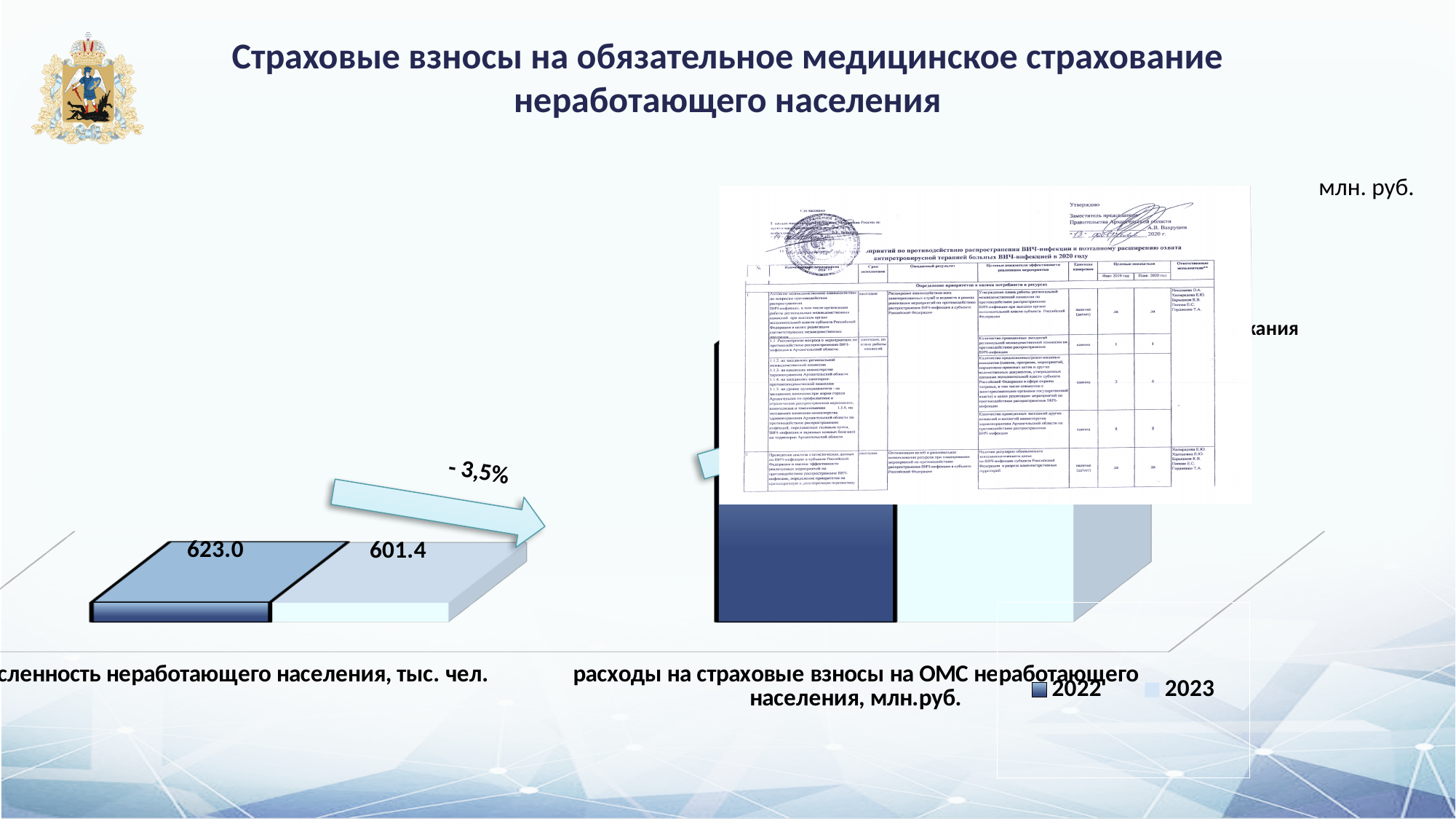
What is the value for 2023 in the category 'численность неработающего населения, тыс. чел.'? 601.4 Which year has the lowest value in the category 'численность неработающего населения, тыс. чел.'? 2023 What percentage change is written next to the arrow above the 'численность неработающего населения' bars? - 3,5% How many series does the legend list? 2 What is the value for 2022 in the category 'численность неработающего населения, тыс. чел.'? 623.0 What is the difference between the 2022 and 2023 values for 'численность неработающего населения, тыс. чел.'? 21.6 In the category 'численность неработающего населения, тыс. чел.', which year has the larger value, 2022 or 2023? 2022 What kind of chart is shown on the slide? Bar chart Which years are listed in the legend? 2022 and 2023 How many categories are shown on the x axis of the chart? 2 Does the value for 'численность неработающего населения, тыс. чел.' rise or fall from 2022 to 2023? Fall